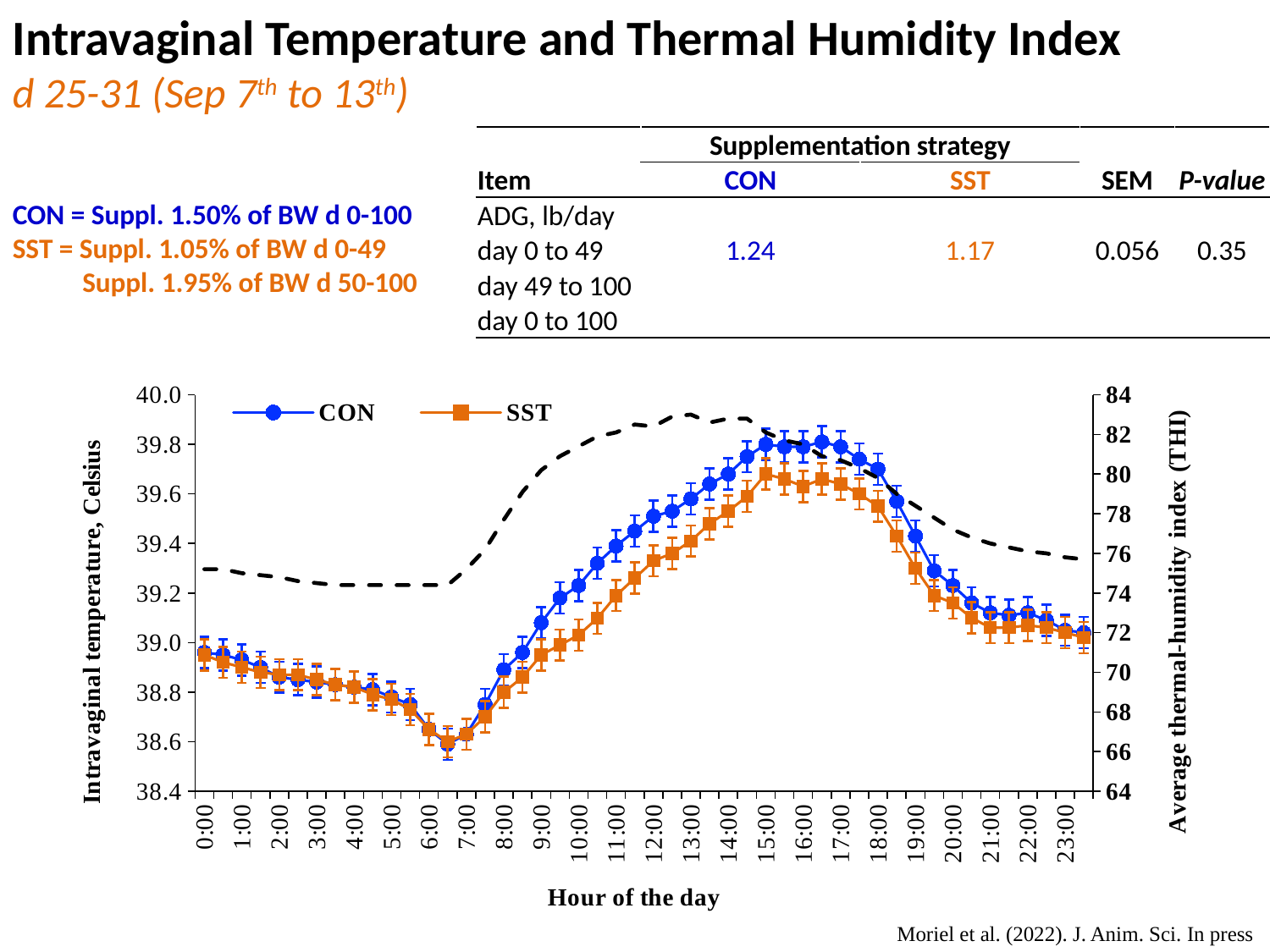
Is the CON intravaginal temperature at 16:00 greater or less than 39.6? greater Does the SST intravaginal temperature rise or fall between 17:00 and 23:00? fall Is the SST intravaginal temperature at 6:00 greater or less than 38.8? less How many series does the chart legend list? 2 Is the CON intravaginal temperature at 23:00 greater or less than 39.2? less Does the CON intravaginal temperature rise or fall between 7:00 and 15:00? rise What is the title of the left vertical axis of the chart? Intravaginal temperature, Celsius What kind of chart is shown on the slide? line chart At 16:00, which series has the higher intravaginal temperature, CON or SST? CON What are the two series named in the chart legend? CON and SST